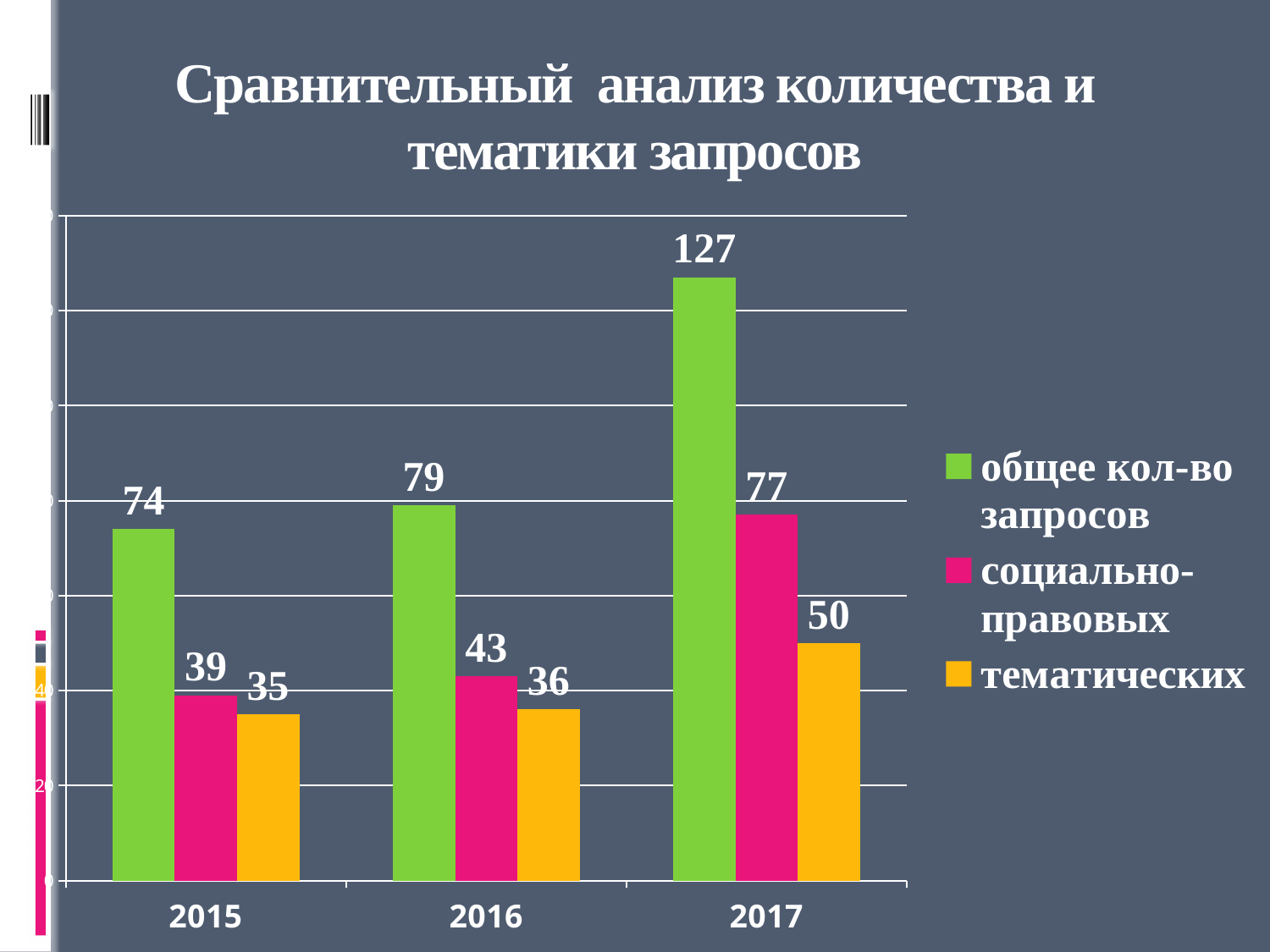
What is the value for социально-правовых in 2016? 43 How many series does the legend list? 3 What is the value for тематических in 2015? 35 What kind of chart is shown on the slide? bar chart In which year is общее кол-во запросов highest? 2017 Does общее кол-во запросов rise or fall from 2015 to 2017? rise In which year is тематических lowest? 2015 What is the difference between общее кол-во запросов in 2017 and in 2016? 48 What is the value for общее кол-во запросов in 2017? 127 What colour are the bars for тематических? orange Which is larger: социально-правовых in 2017 or общее кол-во запросов in 2015? социально-правовых in 2017 How many years are shown on the x axis? 3